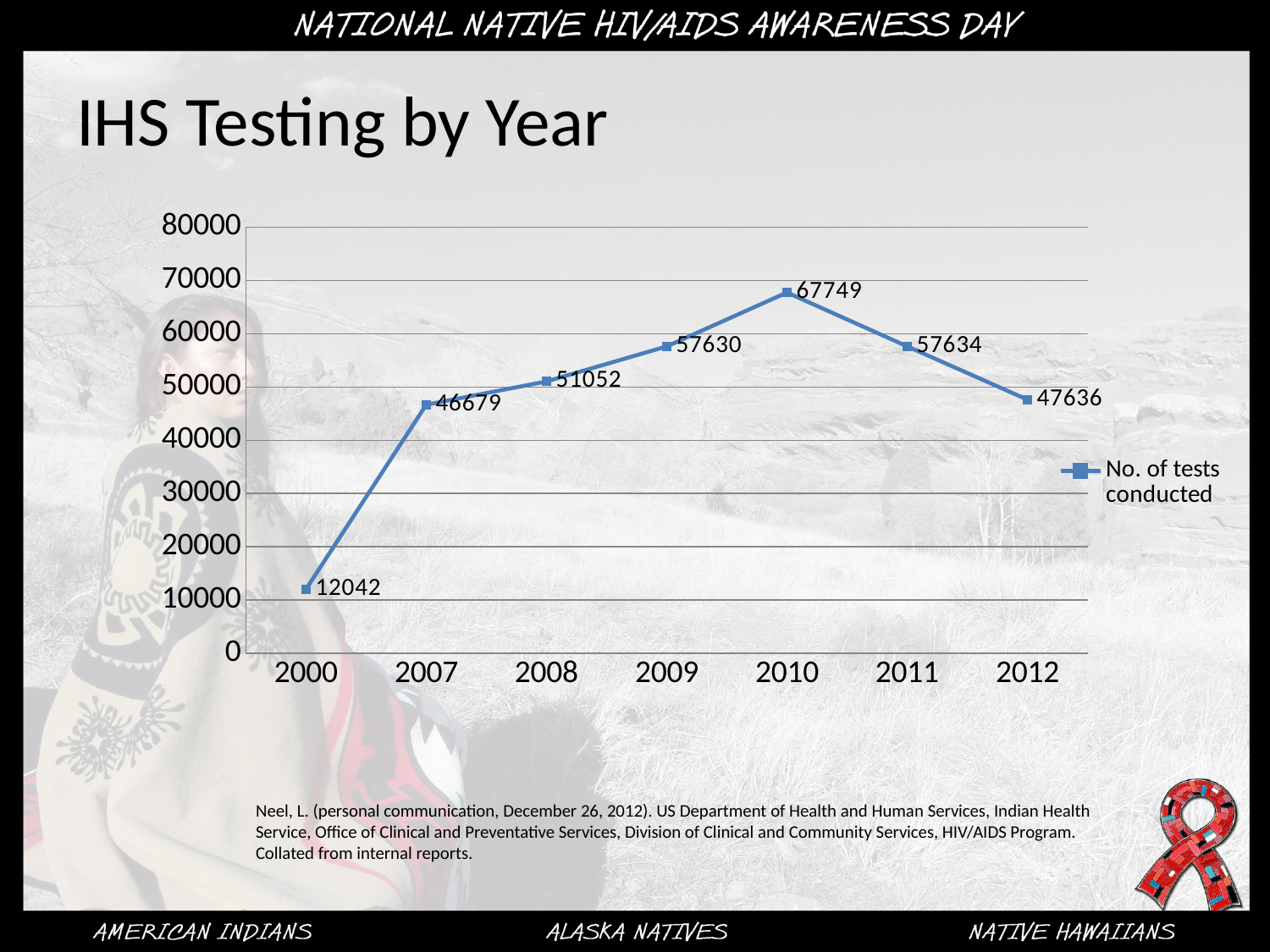
How many years are plotted on the x axis? 7 Which year has the highest number of tests conducted? 2010 Which year has the lowest number of tests conducted? 2000 How many tests were conducted in 2010? 67749 What is the number of tests conducted in 2000? 12042 Which year had more tests conducted, 2008 or 2012? 2008 What is the difference between the number of tests in 2007 and 2000? 34637 What is the difference between the number of tests in 2010 and 2011? 10115 How many series does the legend list? 1 What is the value for 2012? 47636 What type of chart is shown on the slide? line chart Does the number of tests rise or fall from 2010 to 2012? fall